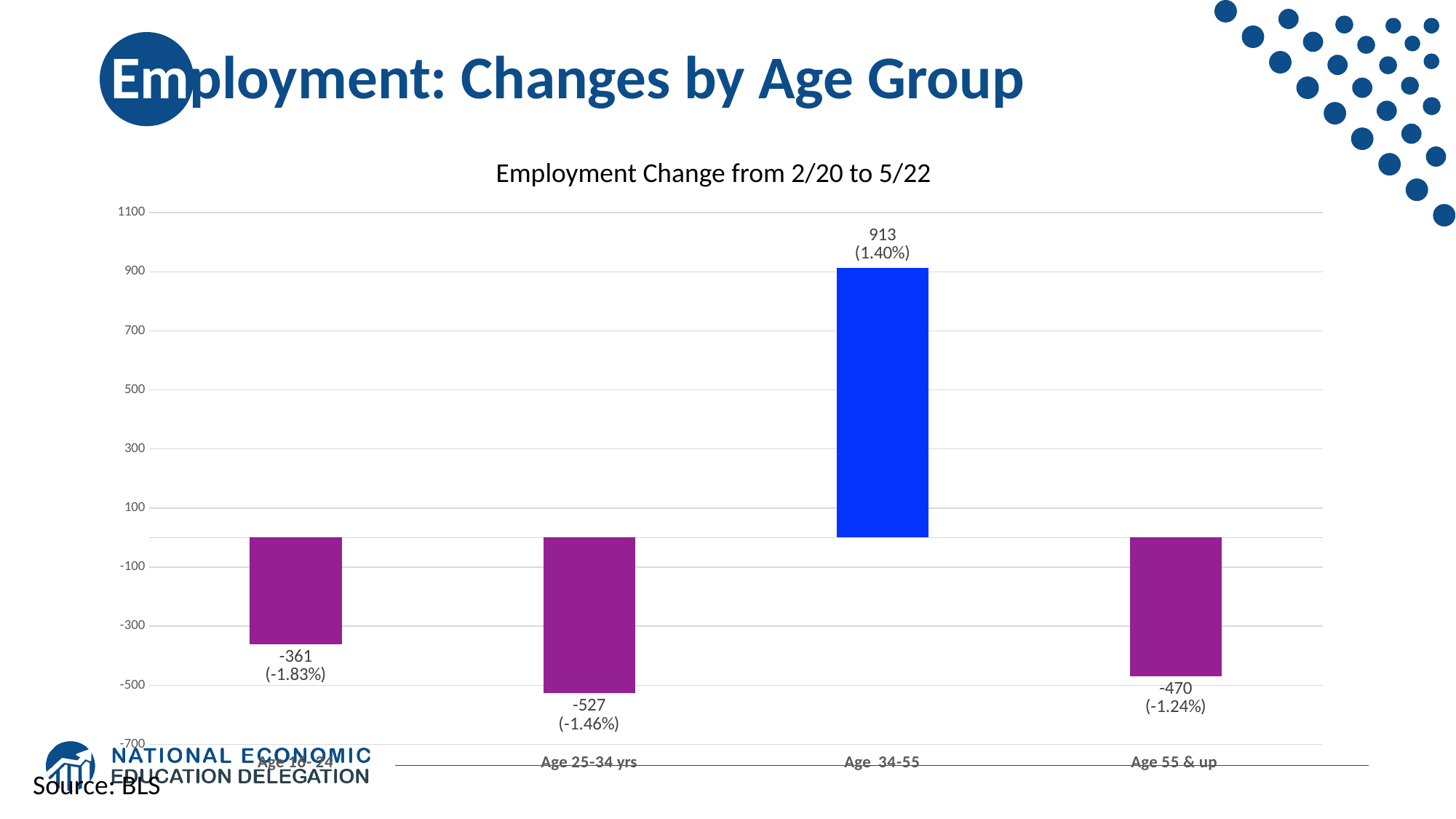
What is the difference between the employment change for Age 34-55 and Age 55 & up? 1383 What is the employment change value shown for Age 34-55? 913 What percentage change is shown for Age 34-55? 1.40% Which has a larger employment change, Age 25-34 yrs or Age 55 & up? Age 55 & up What is the employment change value shown for Age 25-34 yrs? -527 How many age groups are shown in the chart? 4 What type of chart is shown on the slide? Bar chart What percentage change is shown for the leftmost bar in the chart? -1.83% What is the title of the chart? Employment Change from 2/20 to 5/22 What is the employment change value shown for Age 55 & up? -470 Which age group has the highest employment change? Age 34-55 Which age group has the lowest employment change? Age 25-34 yrs